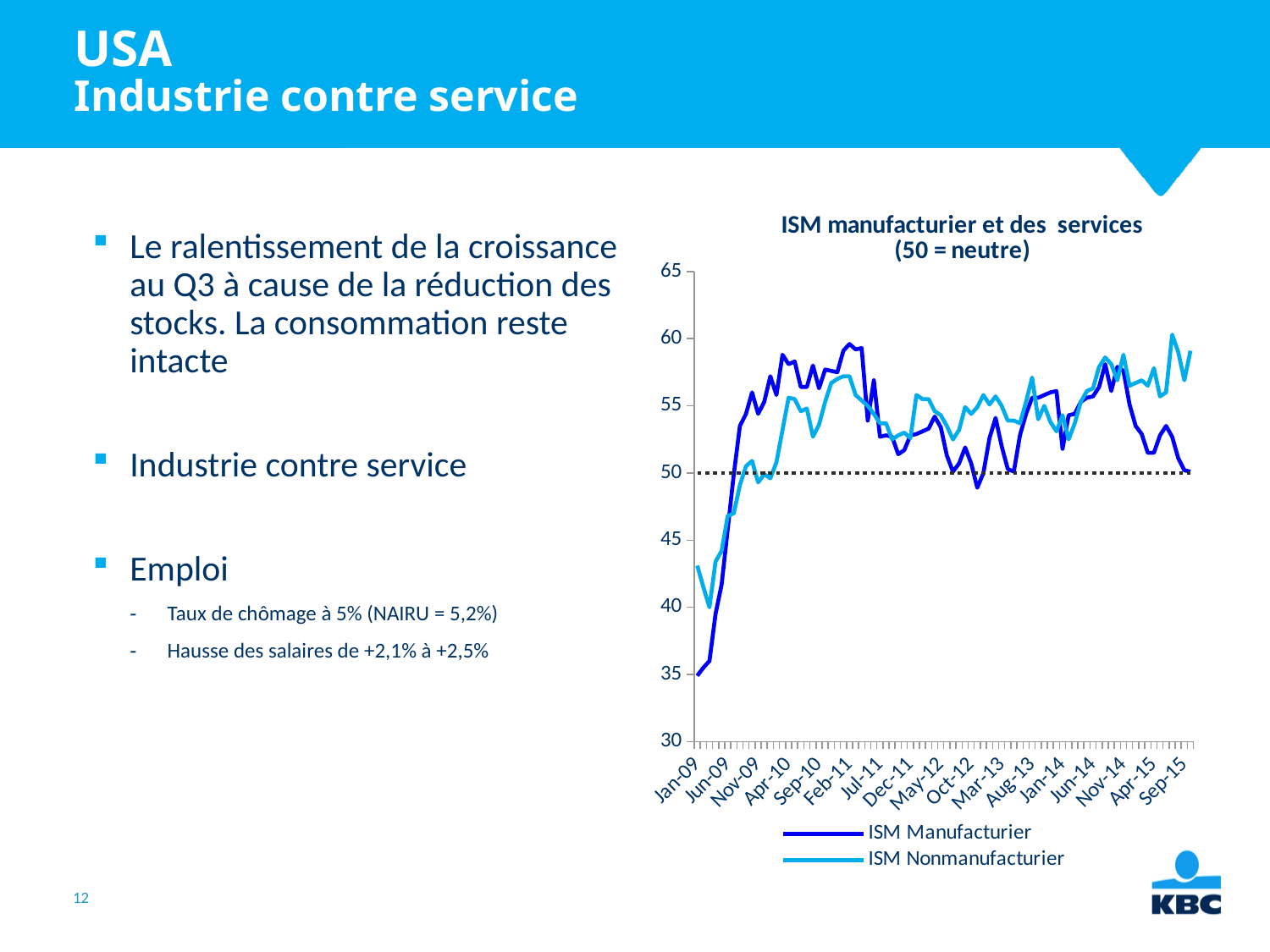
Does the ISM Manufacturier series rise or fall between Jan-09 and Jun-09? rise What is the title of the chart? ISM manufacturier et des services (50 = neutre) At Sep-15, which series has the higher value, ISM Manufacturier or ISM Nonmanufacturier? ISM Nonmanufacturier How many series does the chart legend list? 2 Is the peak value of ISM Manufacturier around Feb-11 greater or less than 55? greater What kind of chart is shown on the slide? line chart Which two series are listed in the chart legend? ISM Manufacturier and ISM Nonmanufacturier At which x-axis label does the ISM Manufacturier series reach its lowest value? Jan-09 At Jan-09, which series has the higher value, ISM Manufacturier or ISM Nonmanufacturier? ISM Nonmanufacturier Is the value of ISM Nonmanufacturier at Jan-09 greater or less than 40? greater Is the value of ISM Manufacturier at Jan-09 greater or less than 40? less